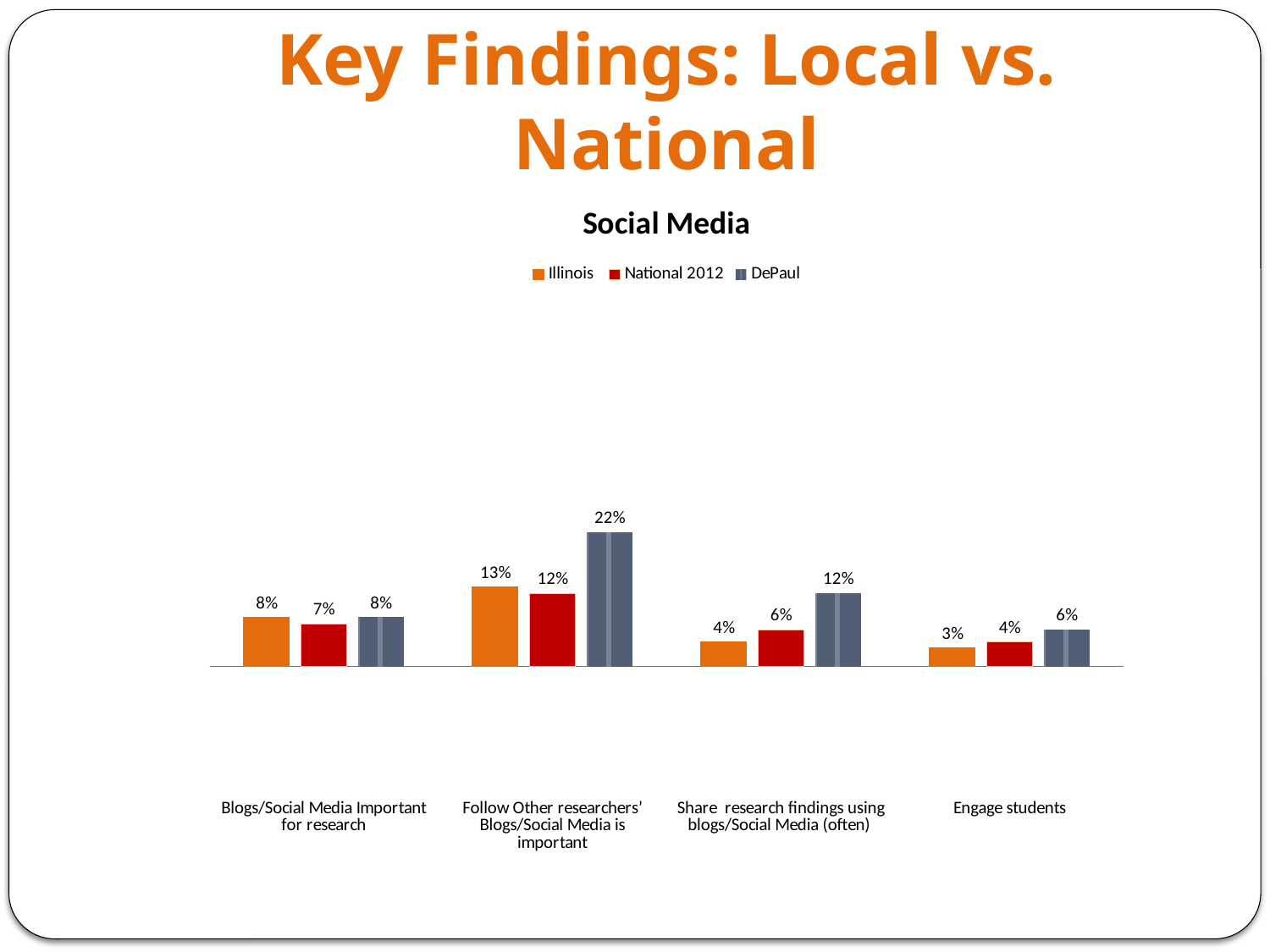
Which is larger for "Blogs/Social Media Important for research": the Illinois value or the National 2012 value? Illinois What is the difference between the DePaul and Illinois values for "Share research findings using blogs/Social Media (often)"? 8% What is the DePaul value for "Follow Other researchers' Blogs/Social Media is important"? 22% What is the difference between the DePaul and Illinois values for "Follow Other researchers' Blogs/Social Media is important"? 9% What is the Illinois value for "Engage students"? 3% How many series does the legend list? 3 What is the National 2012 value for "Share research findings using blogs/Social Media (often)"? 6% Which category has the lowest Illinois value? Engage students What is the National 2012 value for "Blogs/Social Media Important for research"? 7% How many categories are shown on the x axis? 4 Which category has the highest DePaul value? Follow Other researchers' Blogs/Social Media is important What type of chart is shown? Bar chart